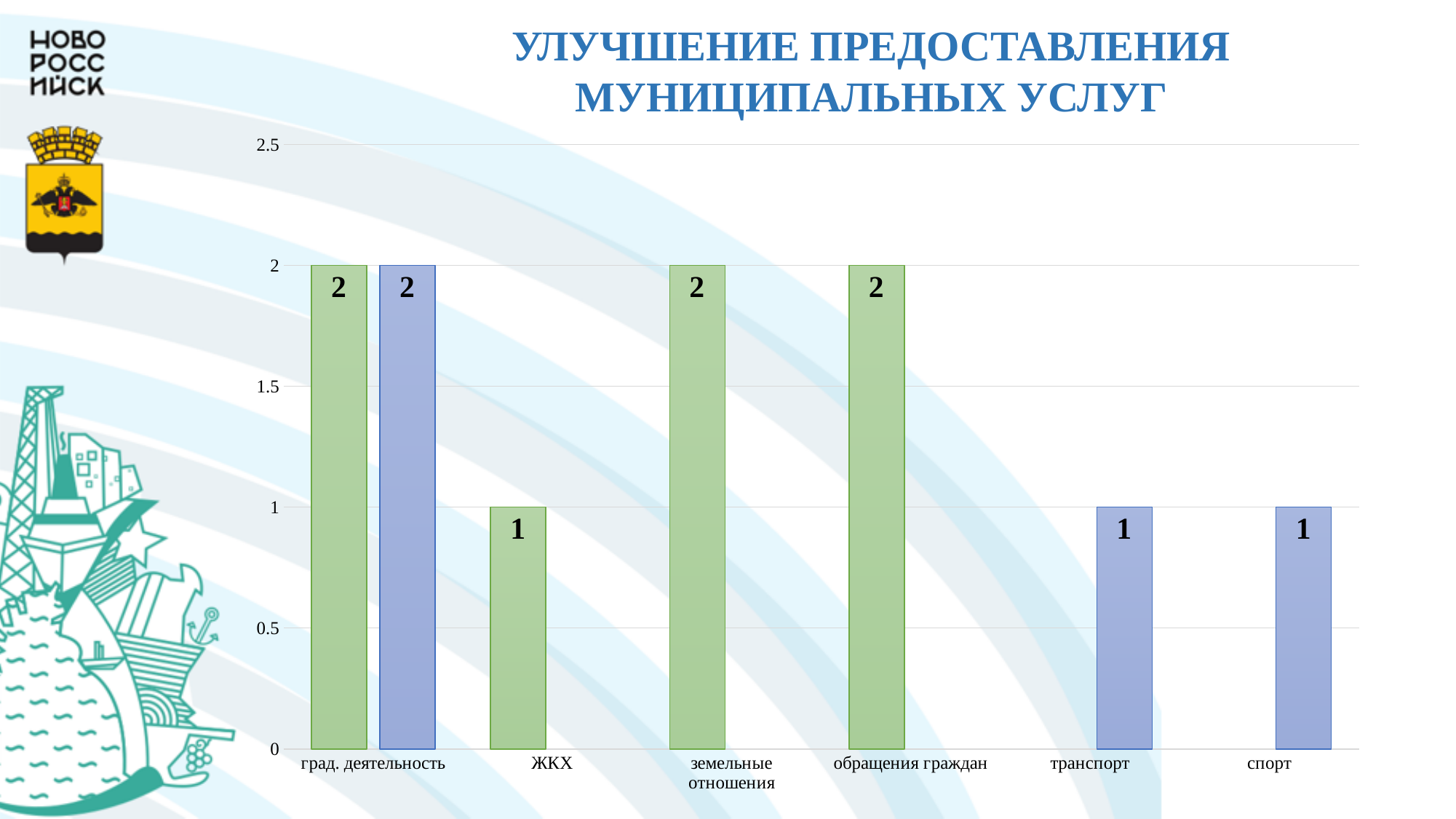
What is the difference between the green bar for земельные отношения and the green bar for ЖКХ? 1 What is the title of the chart on the slide? УЛУЧШЕНИЕ ПРЕДОСТАВЛЕНИЯ МУНИЦИПАЛЬНЫХ УСЛУГ Which category has the lowest green bar? ЖКХ What type of chart is shown on the slide? bar chart What is the value of the green bar for земельные отношения? 2 What is the value of the green bar for обращения граждан? 2 Which is larger: the green bar for обращения граждан or the blue bar for спорт? обращения граждан What is the value of the blue bar for транспорт? 1 Which category has the highest blue bar? град. деятельность How many categories are shown on the x axis of the chart? 6 What is the value of the green bar for ЖКХ? 1 What is the value of the blue bar for спорт? 1